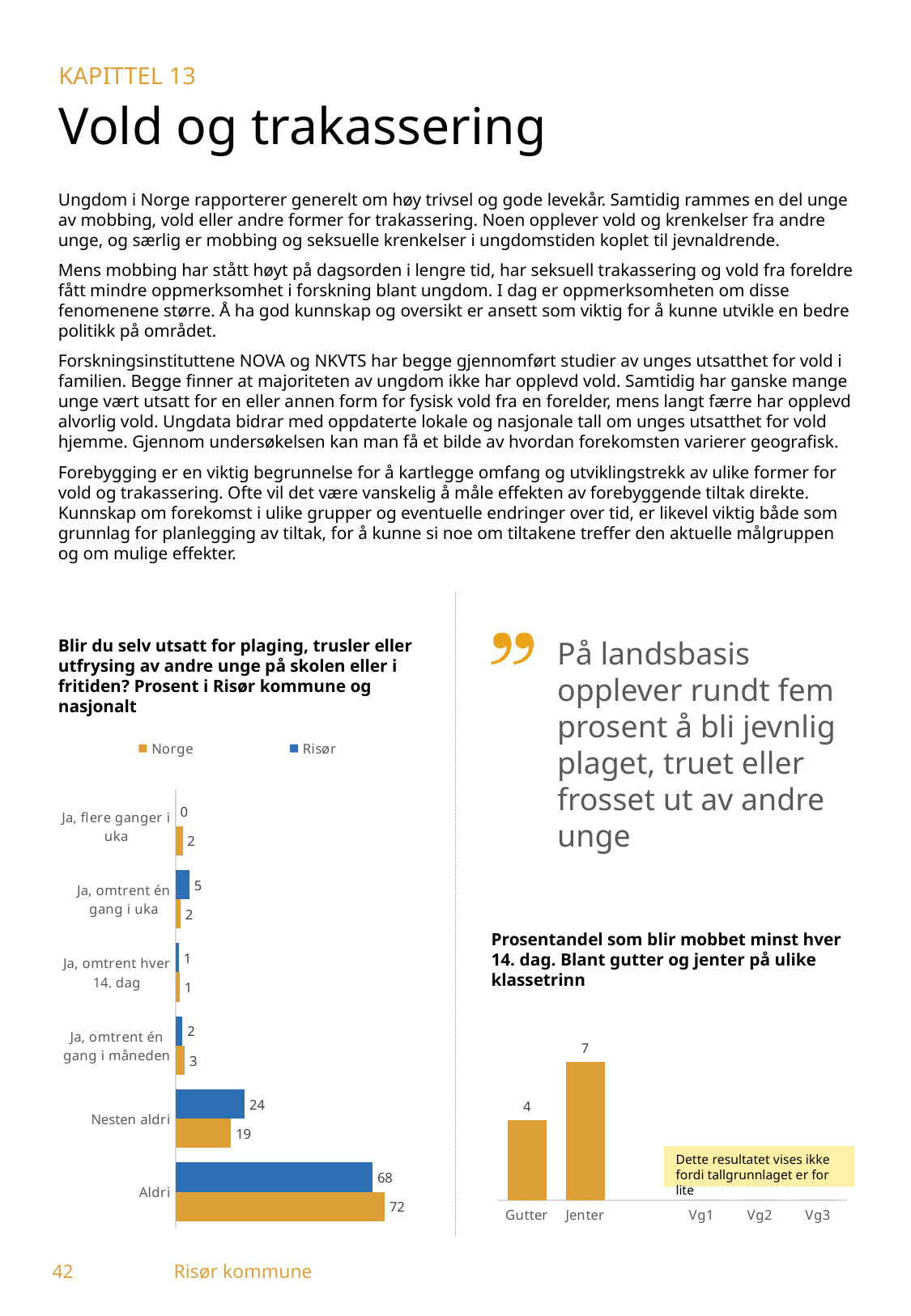
In the chart titled "Blir du selv utsatt for plaging, trusler eller utfrysing av andre unge på skolen eller i fritiden?", what is the value for Risør in the category "Ja, omtrent én gang i uka"? 5 How many categories are shown in the chart titled "Blir du selv utsatt for plaging, trusler eller utfrysing av andre unge på skolen eller i fritiden?"? 6 In the chart titled "Prosentandel som blir mobbet minst hver 14. dag", what is the difference between Jenter and Gutter? 3 How many series does the legend list in the chart titled "Blir du selv utsatt for plaging, trusler eller utfrysing av andre unge på skolen eller i fritiden?"? 2 In the chart titled "Blir du selv utsatt for plaging, trusler eller utfrysing av andre unge på skolen eller i fritiden?", what is the difference between Norge and Risør in the category "Aldri"? 4 In the chart titled "Blir du selv utsatt for plaging, trusler eller utfrysing av andre unge på skolen eller i fritiden?", which is larger in the category "Nesten aldri": Norge or Risør? Risør In the chart titled "Blir du selv utsatt for plaging, trusler eller utfrysing av andre unge på skolen eller i fritiden?", what is the value for Norge in the category "Nesten aldri"? 19 What kind of chart is the chart titled "Prosentandel som blir mobbet minst hver 14. dag"? Bar chart In the chart titled "Blir du selv utsatt for plaging, trusler eller utfrysing av andre unge på skolen eller i fritiden?", which category has the lowest value for Risør? Ja, flere ganger i uka In the chart titled "Prosentandel som blir mobbet minst hver 14. dag", what is the value for Jenter? 7 In the chart titled "Blir du selv utsatt for plaging, trusler eller utfrysing av andre unge på skolen eller i fritiden?", what is the value for Risør in the category "Aldri"? 68 In the chart titled "Blir du selv utsatt for plaging, trusler eller utfrysing av andre unge på skolen eller i fritiden?", which category has the highest value for Norge? Aldri